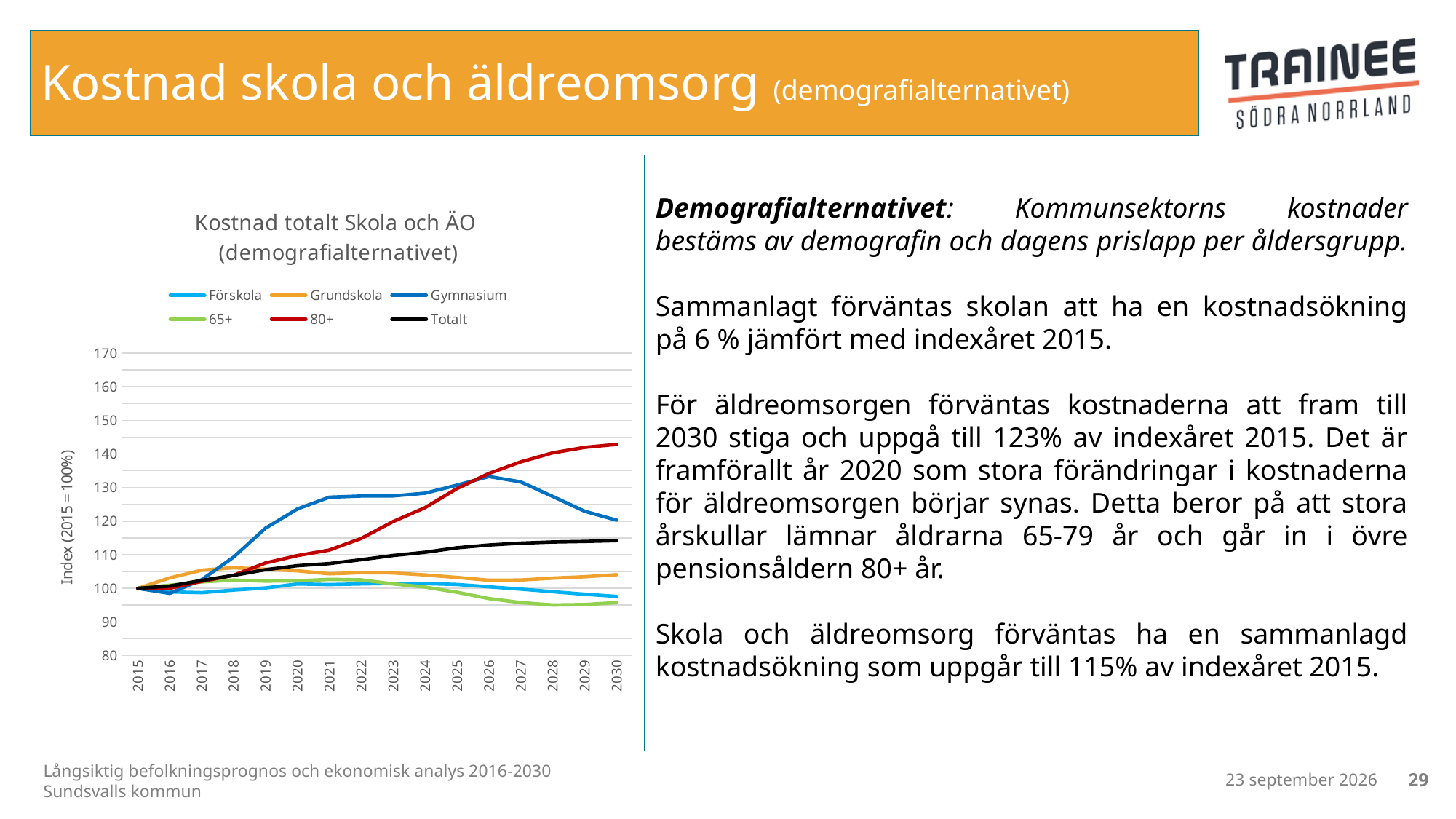
How many years are shown along the x axis of the chart? 16 Which is larger in 2030, the value for Gymnasium or the value for Grundskola? Gymnasium Is the value for Gymnasium in 2026 greater or less than 120? greater Does the Totalt series rise or fall from 2015 to 2030? rise Which series has the lowest value in 2030? 65+ What kind of chart is shown on the slide? line chart Is the value for 80+ in 2030 greater or less than 130? greater How many series does the legend of the chart list? 6 What is the index value of all series in 2015? 100 Which series has the highest value in 2030? 80+ Is the value for 65+ in 2030 greater or less than 100? less Which is larger in 2021, the value for Gymnasium or the value for 80+? Gymnasium